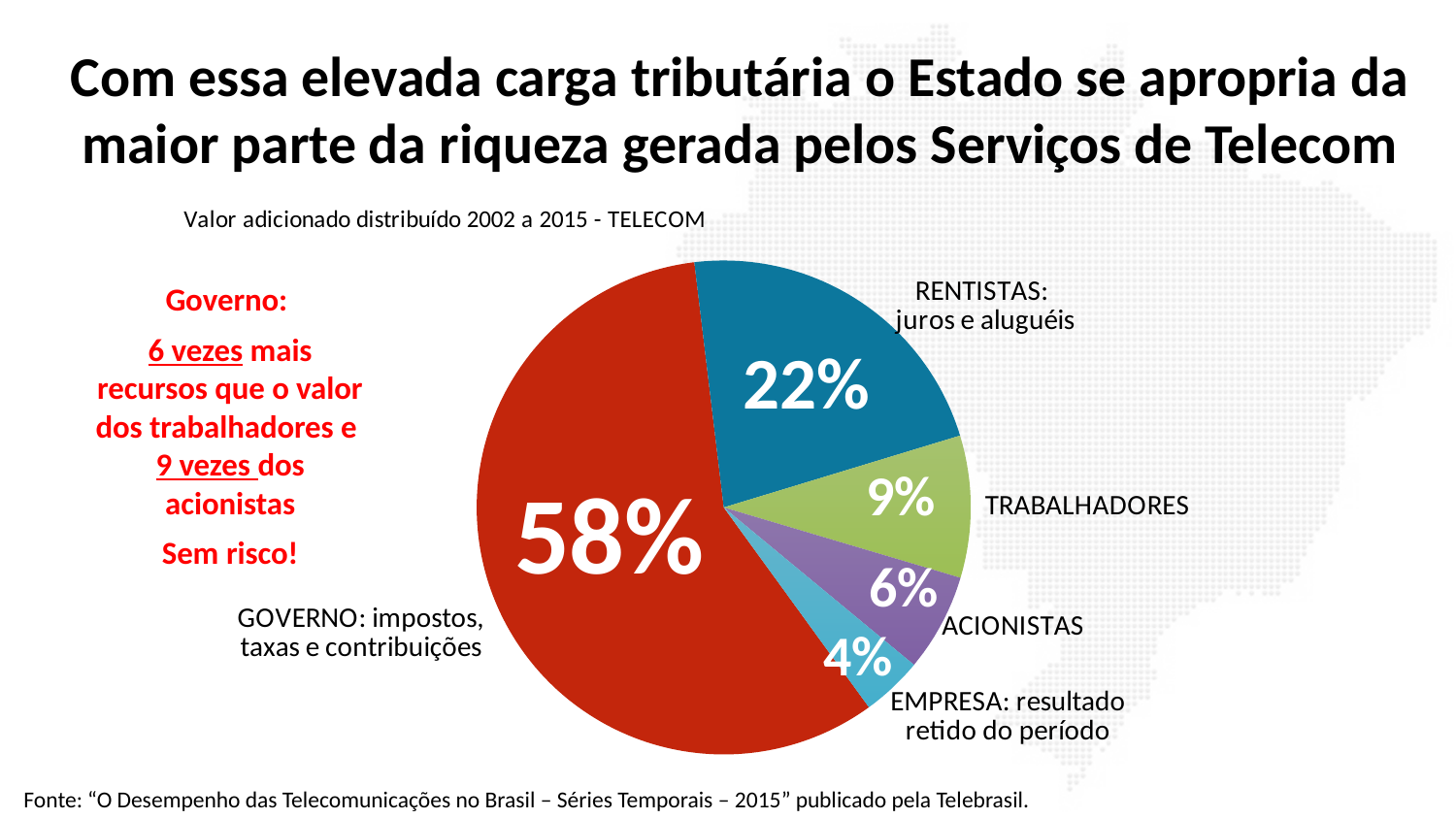
How many slices does the pie chart have? 5 What share of the pie does EMPRESA (resultado retido do período) hold? 4% Which category has the smallest slice of the pie? EMPRESA What is the title of the pie chart? Valor adicionado distribuído 2002 a 2015 - TELECOM Which category has the largest slice of the pie? GOVERNO What share of the pie does ACIONISTAS hold? 6% What kind of chart is shown on the slide? pie chart What share of the pie does RENTISTAS (juros e aluguéis) hold? 22% Which slice is larger, TRABALHADORES or ACIONISTAS? TRABALHADORES What is the difference in percentage points between the GOVERNO slice and the RENTISTAS slice? 36